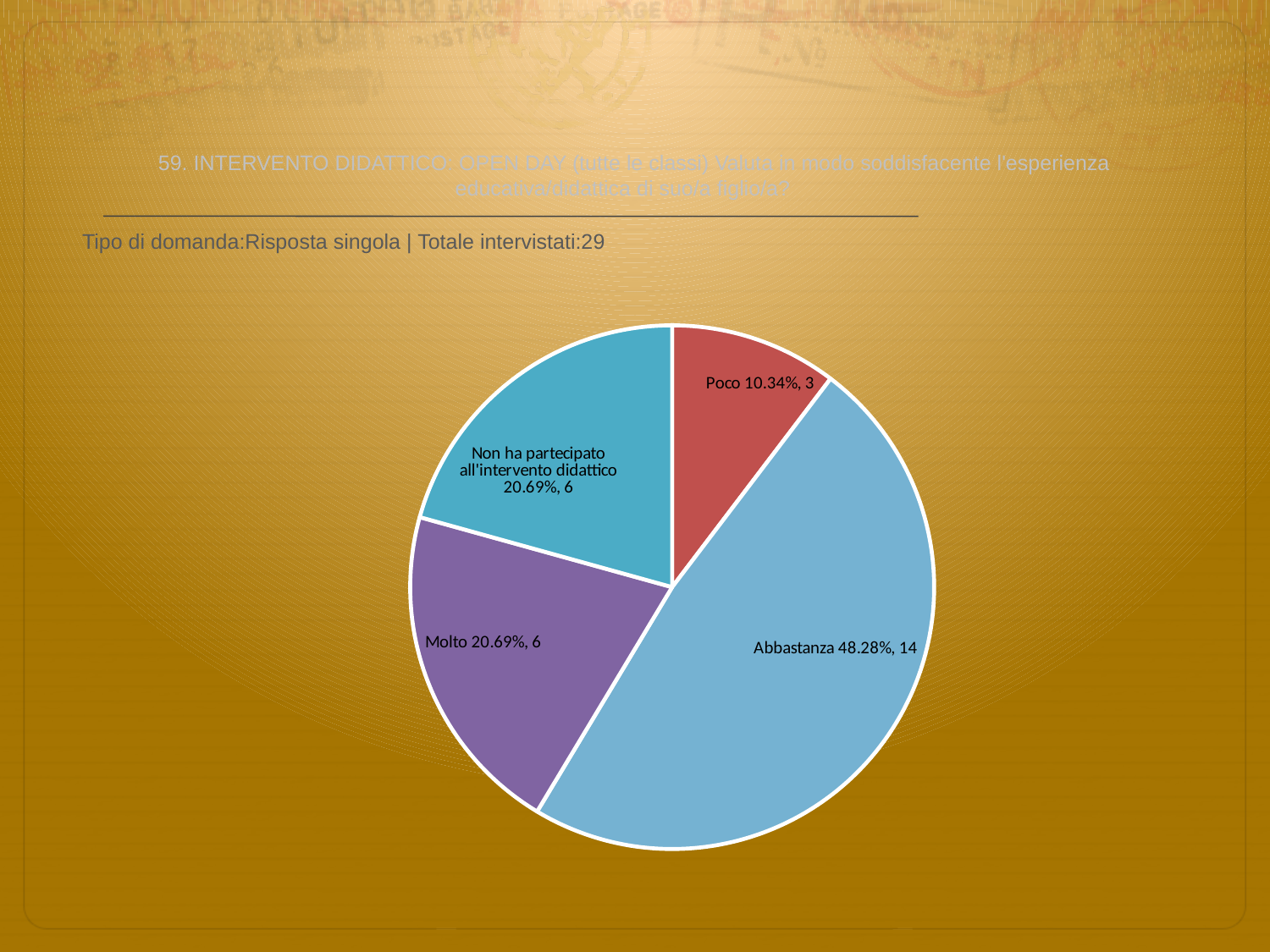
How many slices does the pie chart have? 4 What is the total number of respondents shown on the slide? 29 How many respondents answered Molto? 6 Which category has the smallest slice? Poco What kind of chart is shown on the slide? pie chart What percentage share does the Abbastanza slice have? 48.28% What percentage share does the 'Non ha partecipato all'intervento didattico' slice have? 20.69% Which category has the largest slice? Abbastanza What colour is the Poco slice? red Which is larger, the Abbastanza slice or the Molto slice? Abbastanza What is the difference in respondent count between Abbastanza and Poco? 11 How many respondents answered Poco? 3